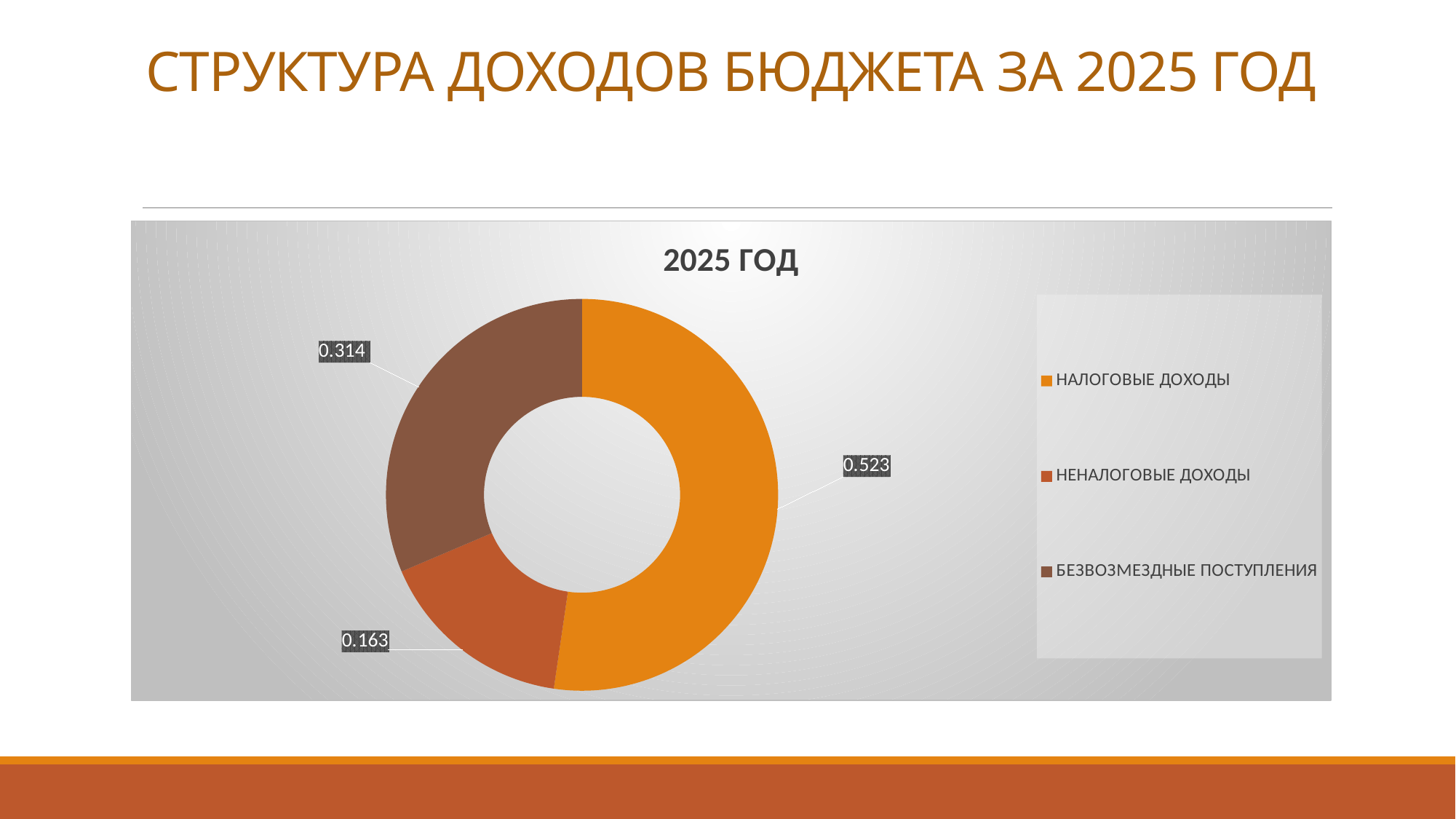
What is the title of the chart? 2025 ГОД How many categories does the chart show? 3 What is the value for БЕЗВОЗМЕЗДНЫЕ ПОСТУПЛЕНИЯ? 0.314 What is the value for НЕНАЛОГОВЫЕ ДОХОДЫ? 0.163 What is the difference between the values for БЕЗВОЗМЕЗДНЫЕ ПОСТУПЛЕНИЯ and НЕНАЛОГОВЫЕ ДОХОДЫ? 0.151 Which legend entry is shown in the dark brown colour? БЕЗВОЗМЕЗДНЫЕ ПОСТУПЛЕНИЯ Which is larger, the value for БЕЗВОЗМЕЗДНЫЕ ПОСТУПЛЕНИЯ or the value for НЕНАЛОГОВЫЕ ДОХОДЫ? БЕЗВОЗМЕЗДНЫЕ ПОСТУПЛЕНИЯ Which category has the largest share of the chart? НАЛОГОВЫЕ ДОХОДЫ What is the value for НАЛОГОВЫЕ ДОХОДЫ? 0.523 What kind of chart is shown on the slide? Doughnut (pie) chart What is the difference between the values for НАЛОГОВЫЕ ДОХОДЫ and БЕЗВОЗМЕЗДНЫЕ ПОСТУПЛЕНИЯ? 0.209 Which category has the smallest share of the chart? НЕНАЛОГОВЫЕ ДОХОДЫ